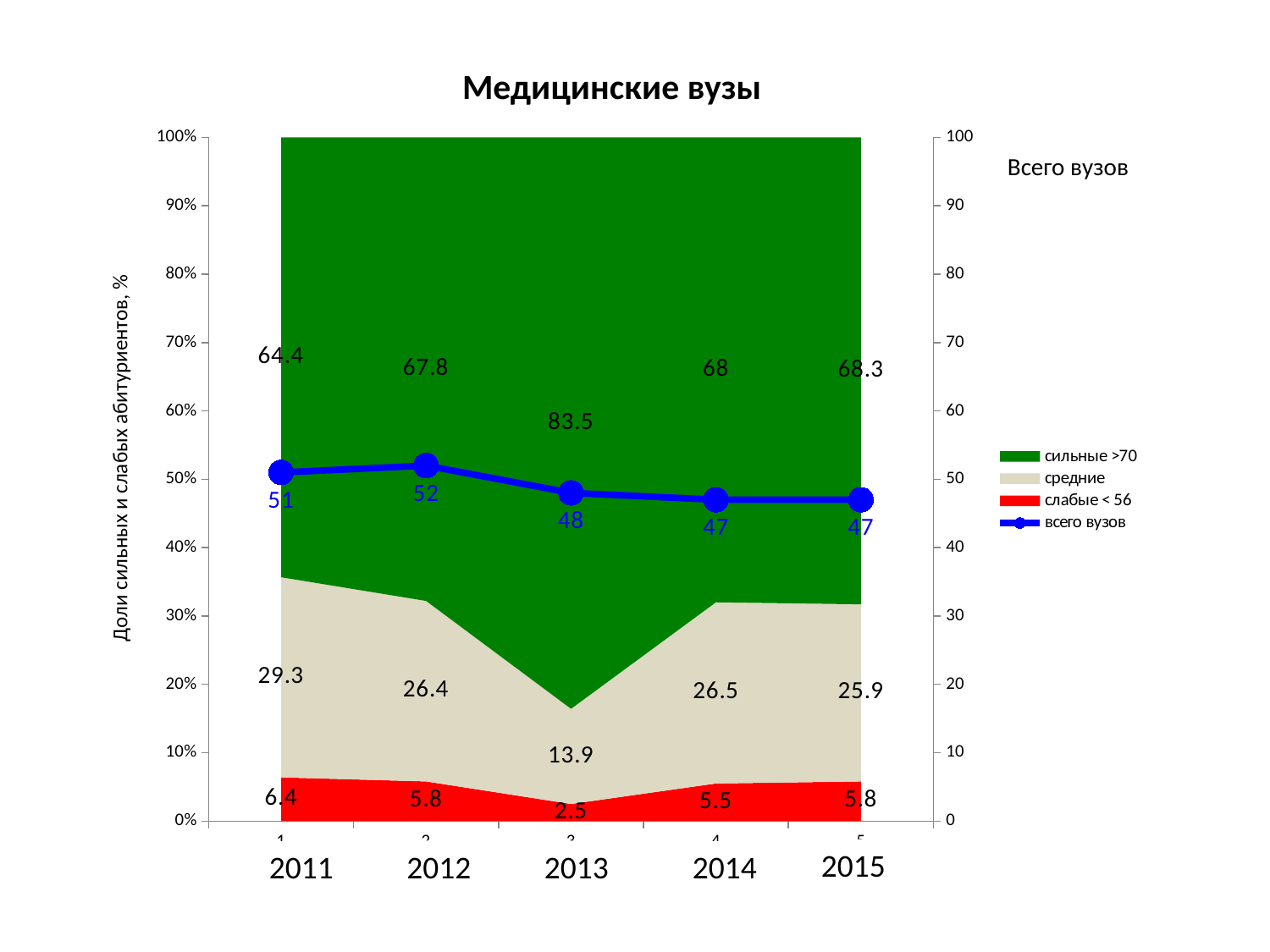
Which is larger: the 'сильные >70' value in 2012 or in 2015? 2015 In which year is the 'слабые < 56' series lowest? 2013 What is the value of 'всего вузов' in 2012? 52 What is the value of the 'слабые < 56' series in 2015? 5.8 What is the value of the 'сильные >70' series in 2013? 83.5 What is the difference between the 'средние' values in 2011 and 2013? 15.4 In which year is the 'сильные >70' series highest? 2013 What is the value of the 'средние' series in 2011? 29.3 How many series does the legend list? 4 What is the title of the chart? Медицинские вузы How many years are shown on the x axis? 5 Does the 'всего вузов' line rise or fall from 2012 to 2015? fall